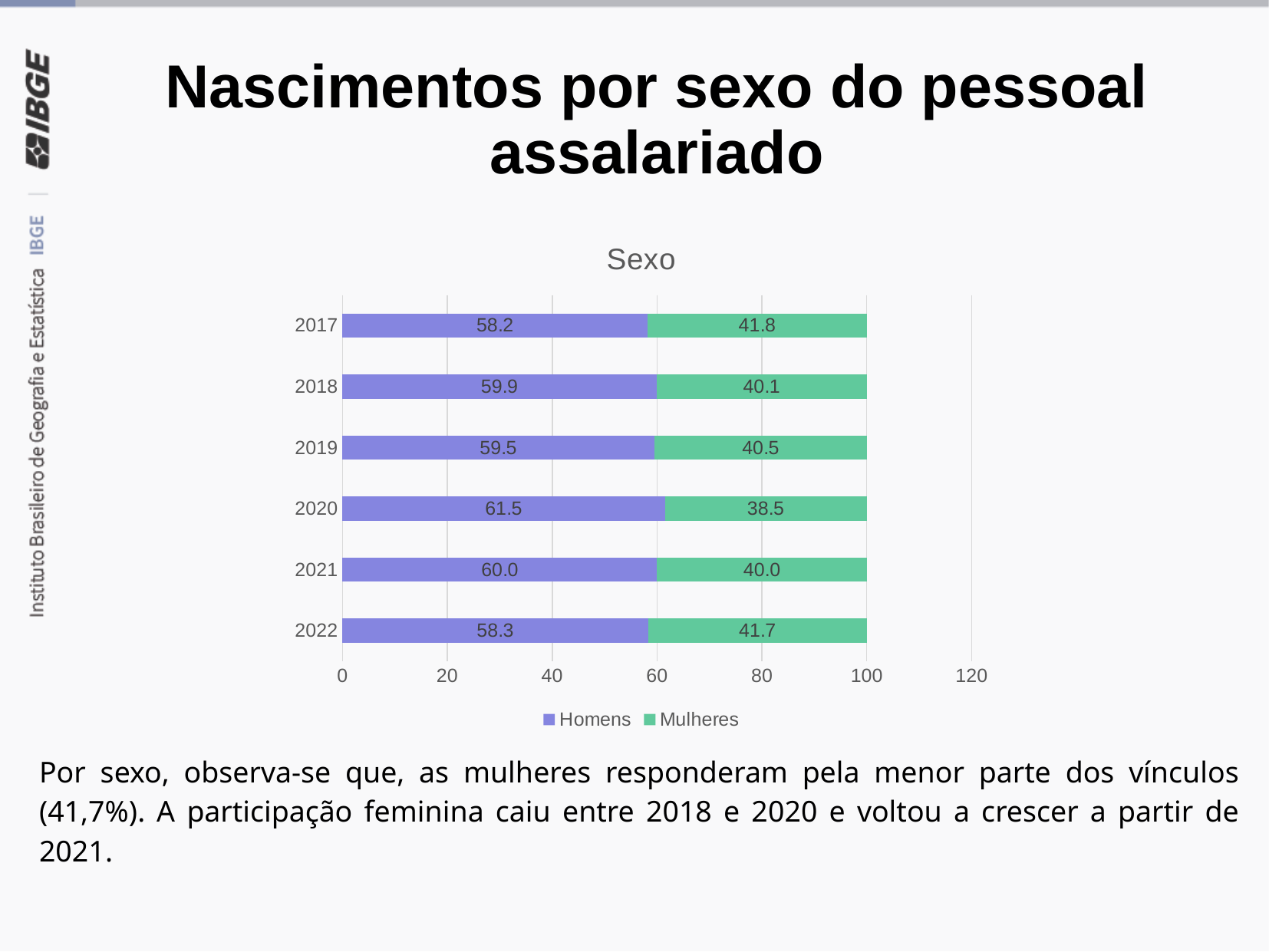
What is the title of the chart? Sexo What is the total of the stacked bar for 2018? 100.0 Which year has the highest value for Homens? 2020 What is the value for Mulheres in 2017? 41.8 How many series does the legend list? 2 What is the difference between the Homens and Mulheres values in 2021? 20.0 Which year has the lowest value for Mulheres? 2020 Which is larger in 2019, the value for Homens or for Mulheres? Homens What is the value for Homens in 2020? 61.5 What kind of chart is shown on the slide? Stacked bar chart How many years are shown on the chart? 6 What is the value for Mulheres in 2022? 41.7